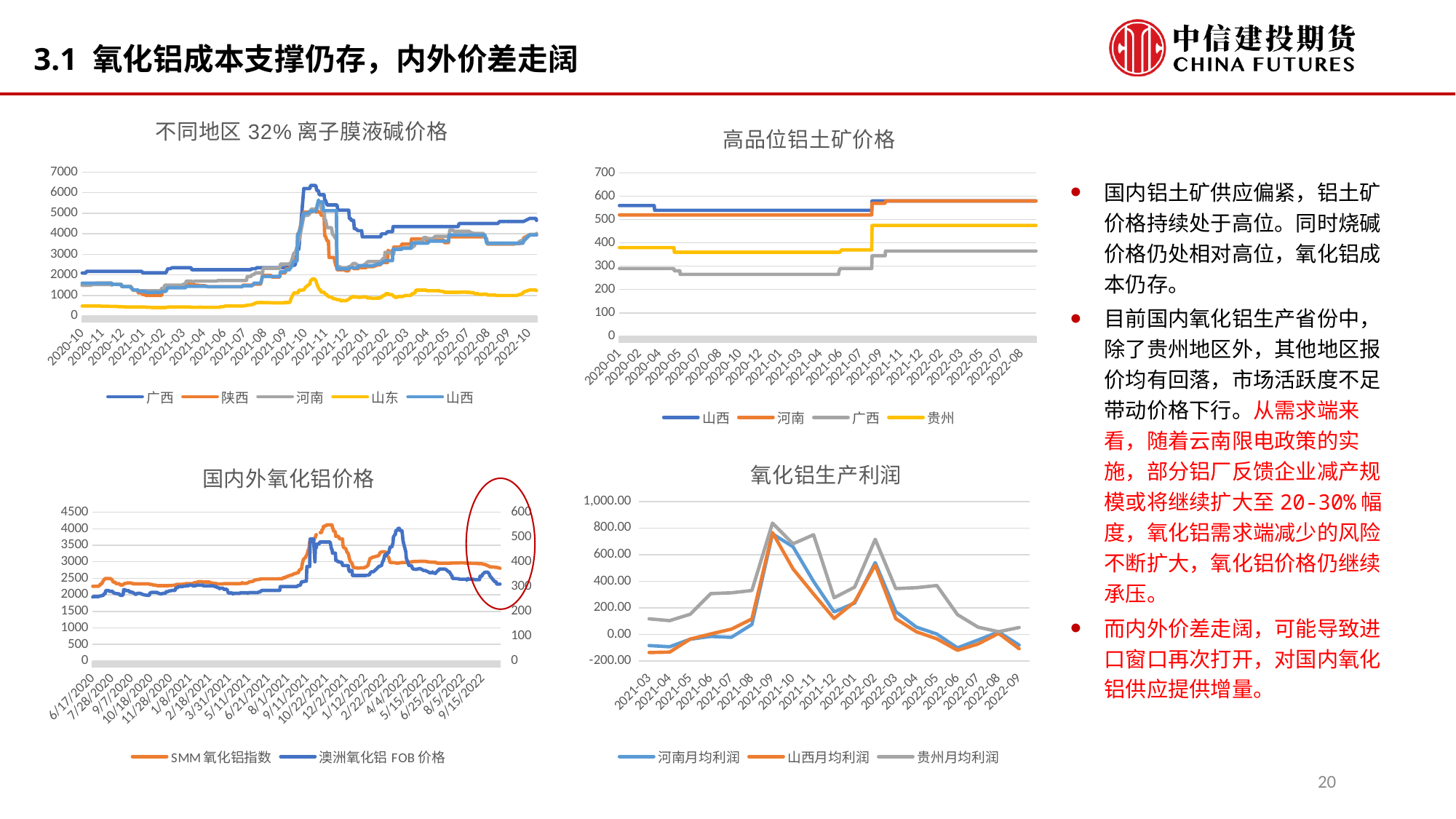
What kind of chart is the chart titled 高品位铝土矿价格? line chart What are the two series listed in the legend of the chart titled 国内外氧化铝价格? SMM 氧化铝指数 and 澳洲氧化铝 FOB 价格 How many series does the legend of the chart titled 氧化铝生产利润 list? 3 In the chart titled 不同地区 32% 离子膜液碱价格, which series stays lowest throughout the period? 山东 In the chart titled 不同地区 32% 离子膜液碱价格, is the value for 山东 at 2020-10 greater or less than 1000? less In the chart titled 高品位铝土矿价格, which series has the lowest values across the whole period? 广西 How many series does the legend of the chart titled 不同地区 32% 离子膜液碱价格 list? 5 In the chart titled 氧化铝生产利润, is the value for 贵州月均利润 at 2021-10 greater or less than 800? less In the chart titled 高品位铝土矿价格, is the value for 贵州 at 2022-08 greater or less than 400? greater In the chart titled 氧化铝生产利润, does the 贵州月均利润 line rise or fall from 2022-05 to 2022-08? fall In the chart titled 氧化铝生产利润, which series has the highest value at 2021-10? 贵州月均利润